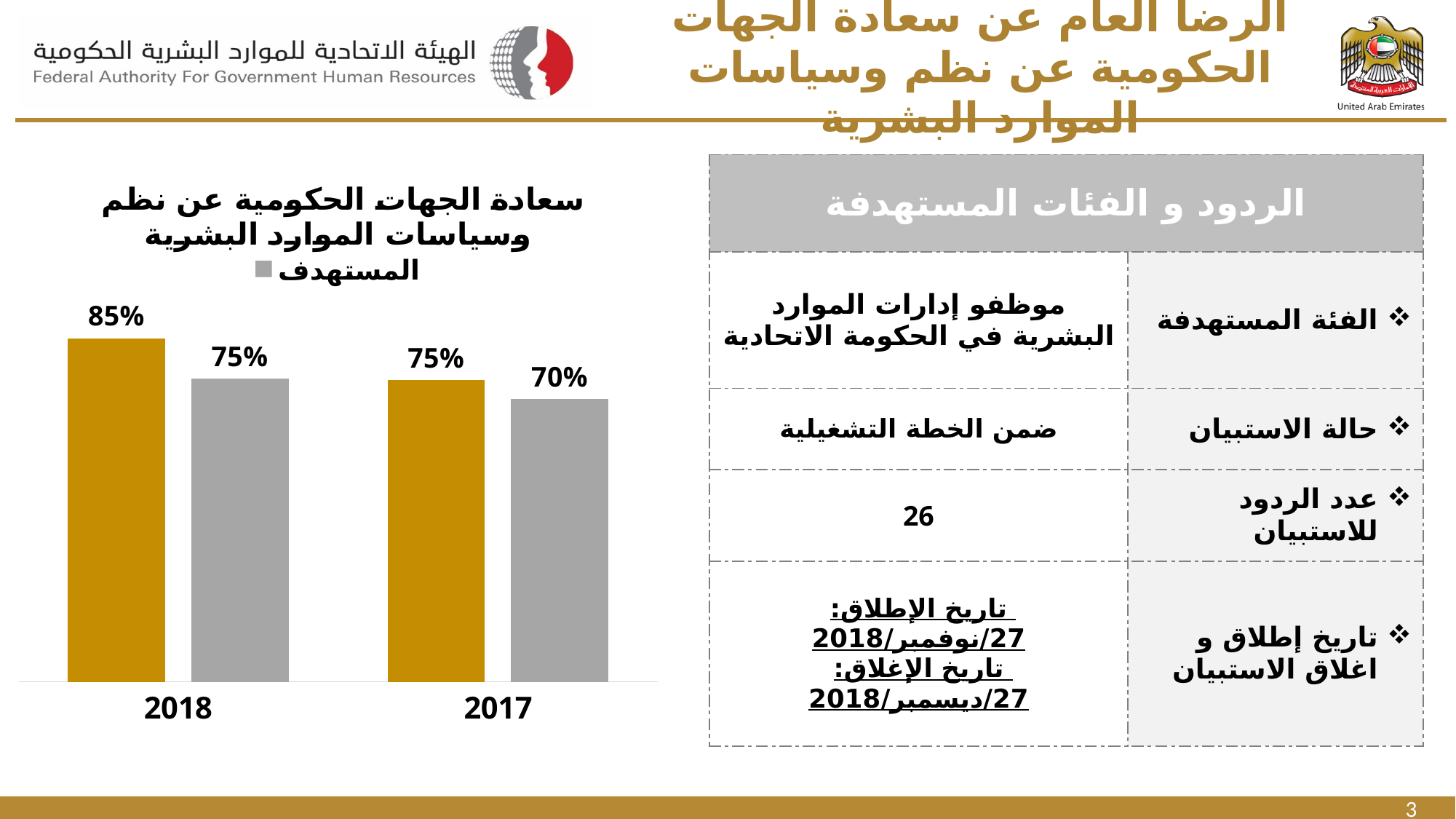
Which year has the lowest gray bar (المستهدف)? 2017 Which is larger for 2017: the gold bar (سعادة الجهات الحكومية) or the gray bar (المستهدف)? the gold bar (سعادة الجهات الحكومية) What is the difference between the gold bar for 2018 and the gold bar for 2017? 10% Which year has the highest gold bar (سعادة الجهات الحكومية)? 2018 What type of chart is shown on the slide? bar chart What is the difference between the gold bar and the gray bar (المستهدف) for 2018? 10% What is the value of the gold bar (سعادة الجهات الحكومية عن نظم وسياسات الموارد البشرية) for 2018? 85% What is the value of the gray bar (المستهدف) for 2017? 70% What is the value of the gray bar (المستهدف) for 2018? 75% How many series does the chart legend list? 1 How many year categories are shown on the x axis of the chart? 2 What is the value of the gold bar (سعادة الجهات الحكومية عن نظم وسياسات الموارد البشرية) for 2017? 75%